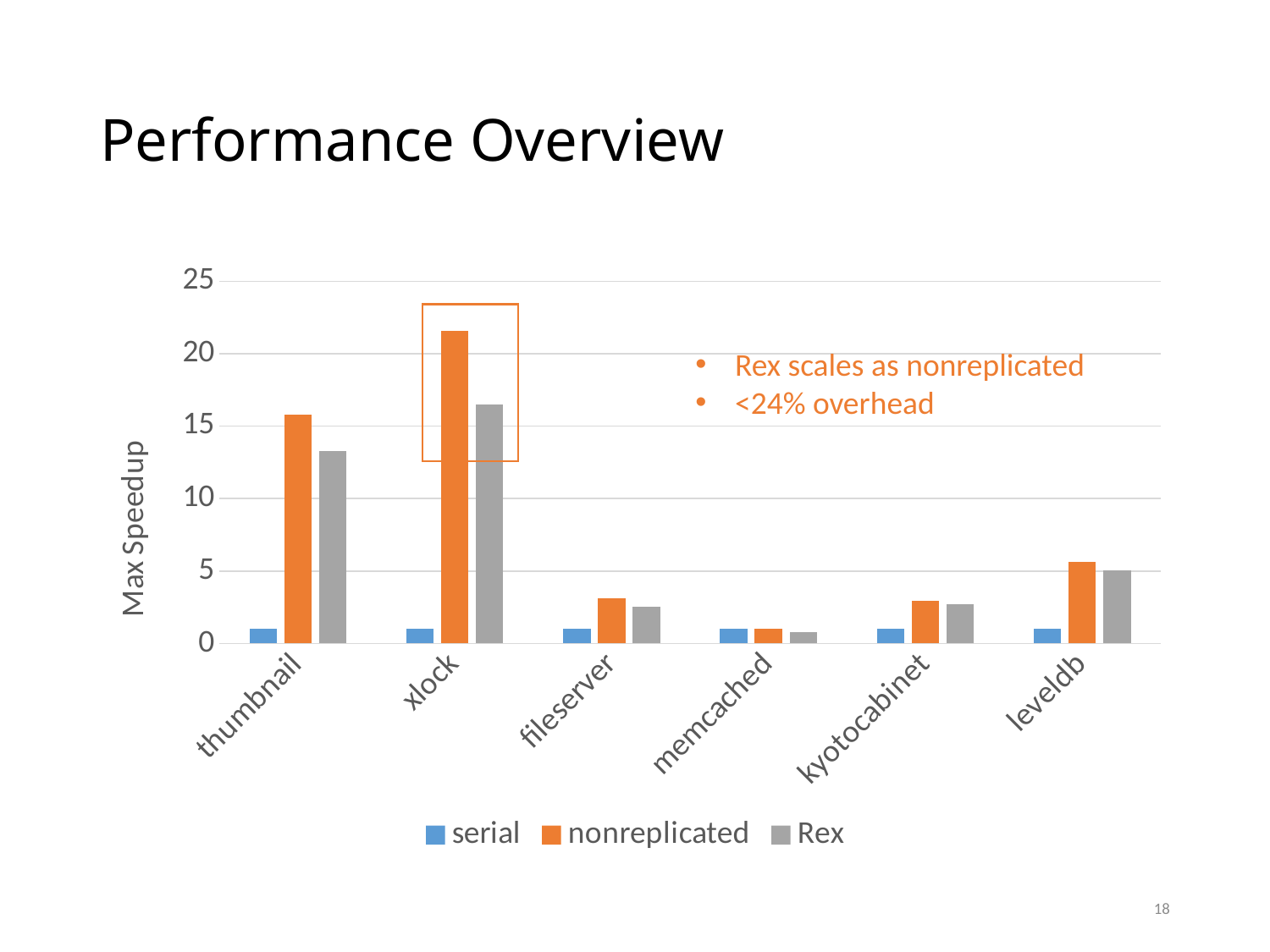
How many series does the chart's legend list? 3 What is the label on the y axis of the chart? Max Speedup Is the Rex value for thumbnail greater or less than 15? less Is the nonreplicated value for fileserver greater or less than 5? less Is the nonreplicated value for xlock greater or less than 20? greater What kind of chart is shown on the slide? bar chart Which category has the highest Rex value? xlock Which category has the highest nonreplicated value? xlock How many categories are shown on the x axis of the chart? 6 For xlock, which is larger: the nonreplicated value or the Rex value? nonreplicated Which category has the lowest Rex value? memcached